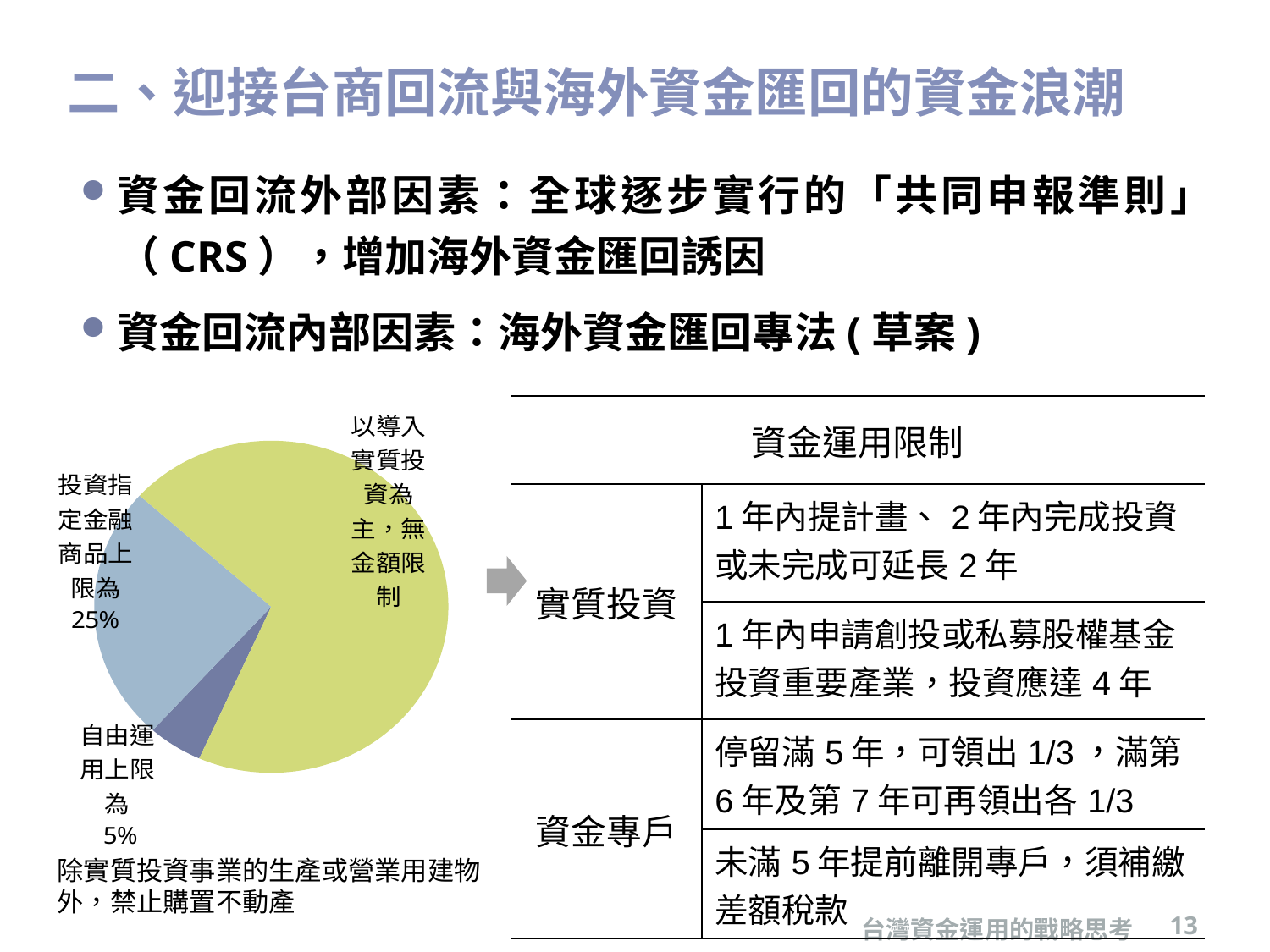
Which slice of the pie chart is the smallest? 自由運用上限為5% How many slices does the pie chart have? 3 What is the difference between the 投資指定金融商品 limit (25%) and the 自由運用 limit (5%) in the pie chart? 20% In the pie chart, which is larger: the 投資指定金融商品 slice or the 自由運用 slice? 投資指定金融商品 Which slice of the pie chart is the largest? 以導入實質投資為主，無金額限制 What is the upper limit shown in the pie chart for 投資指定金融商品? 25% What share of the pie does the 投資指定金融商品 slice represent? 25% What is the upper limit shown in the pie chart for 自由運用? 5% What kind of chart is shown on the left of the slide? pie chart What colour is the largest slice of the pie chart? yellow-green Is the 自由運用 slice of the pie chart greater or less than 10%? less What is the title of the table to the right of the pie chart? 資金運用限制